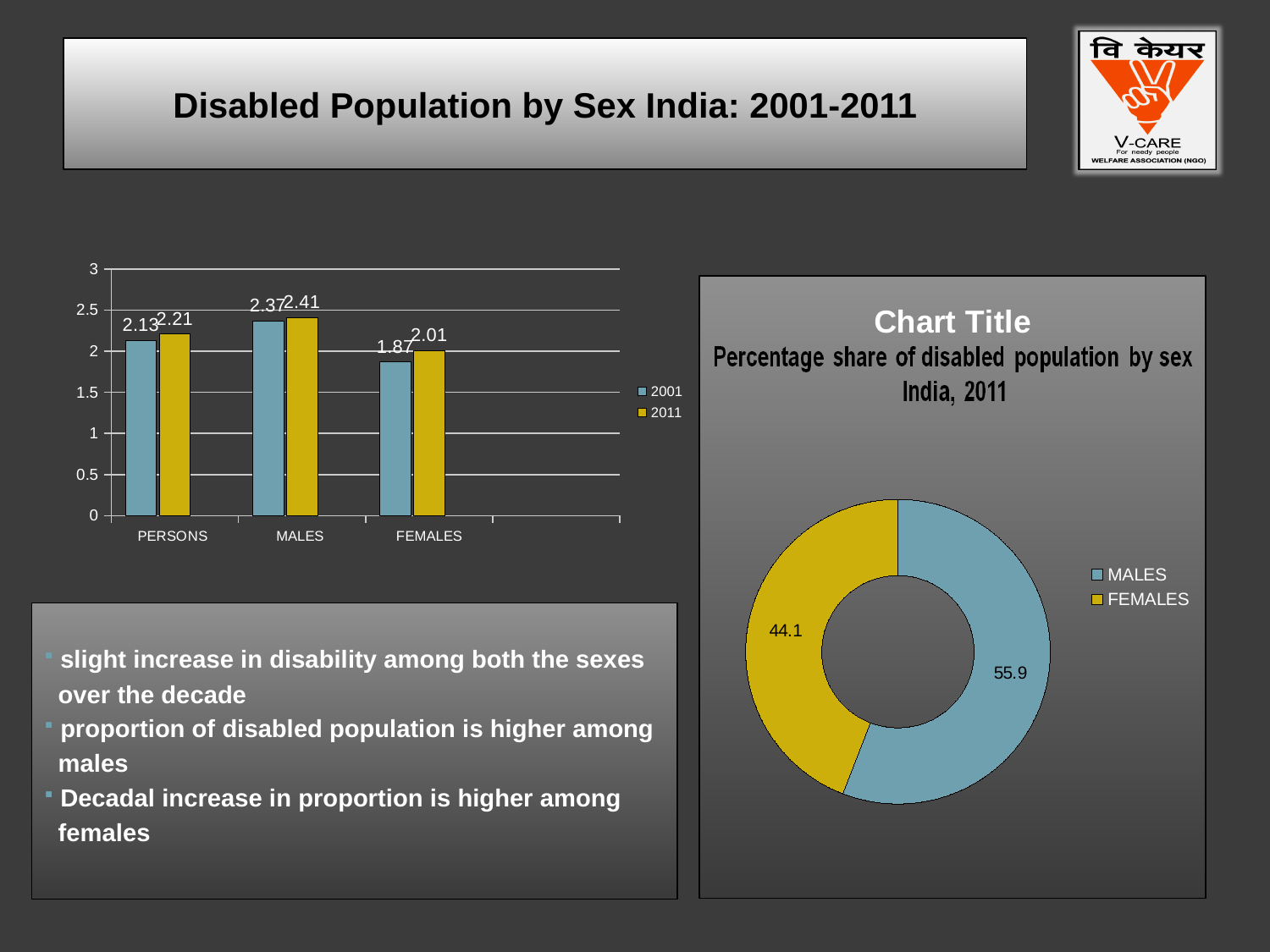
In the doughnut chart on the right, what is the value shown for FEMALES? 44.1 In the bar chart on the left, what is the difference between the 2011 and 2001 values for FEMALES? 0.14 In the bar chart on the left, how many series does the legend list? 2 What kind of chart is the chart on the right of the slide? Doughnut chart In the bar chart on the left, what is the value for PERSONS in 2001? 2.13 In the bar chart on the left, what is the value for FEMALES in 2001? 1.87 In the bar chart on the left, which category has the highest value for 2011? MALES In the bar chart on the left, is the 2001 value for MALES greater or less than the 2011 value for PERSONS? greater In the bar chart on the left, which category has the lowest value for 2001? FEMALES In the bar chart on the left, what is the value for MALES in 2011? 2.41 In the doughnut chart on the right, which segment is larger, MALES or FEMALES? MALES In the bar chart on the left, how many categories are shown on the x axis? 3